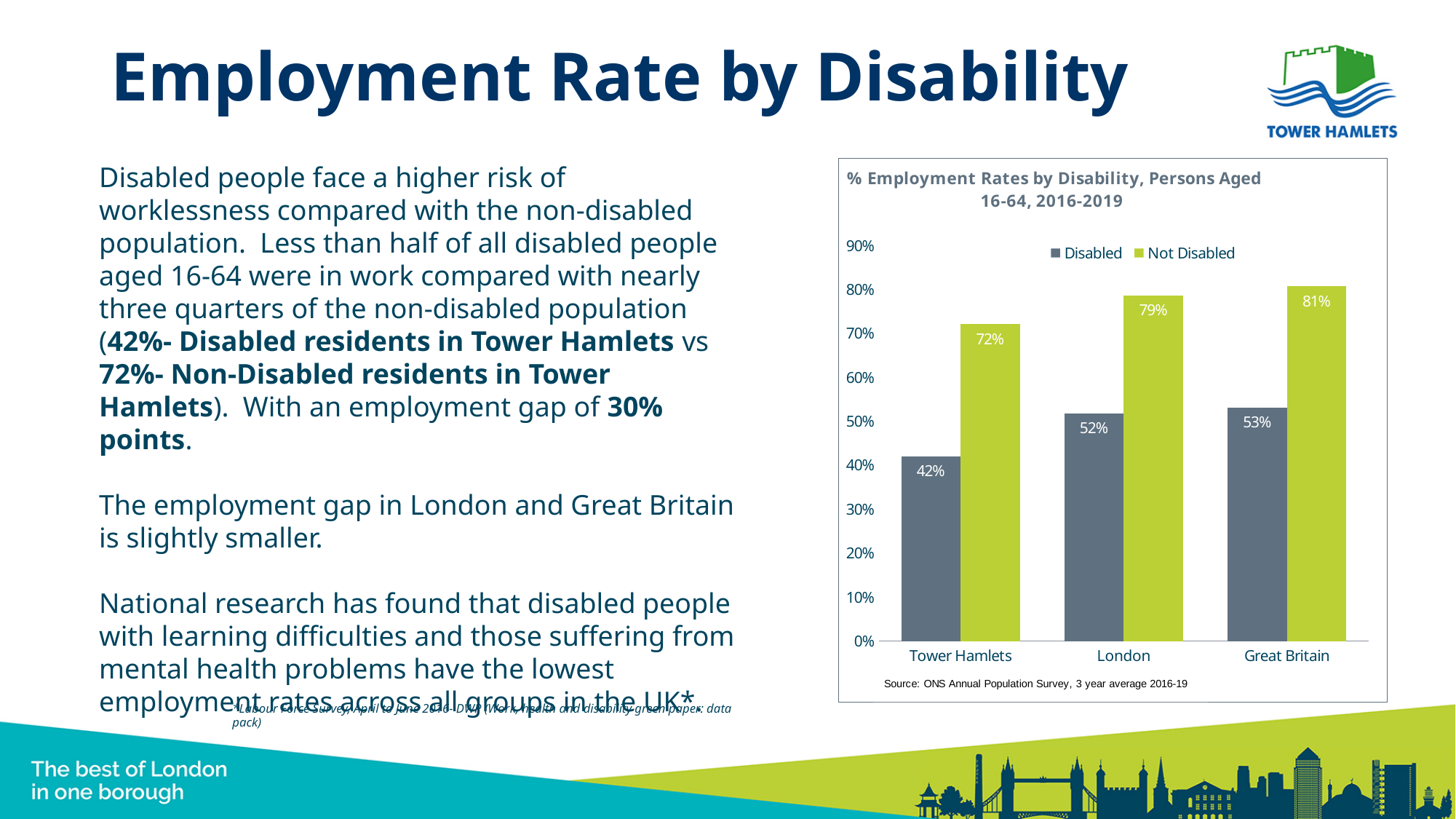
What is the employment rate for disabled people in Tower Hamlets? 42% What is the employment rate for not disabled people in London? 79% How many series does the chart legend list? 2 Which area has the lowest employment rate for disabled people? Tower Hamlets What kind of chart is shown on the slide? Bar chart Is the disabled employment rate in Great Britain greater or less than 50%? greater What is the difference between the not disabled and disabled employment rates in London? 27% Which area has the highest employment rate for not disabled people? Great Britain Which is larger: the disabled employment rate in London or in Tower Hamlets? London What is the employment rate for not disabled people in Great Britain? 81% What is the difference between the not disabled and disabled employment rates in Tower Hamlets? 30% How many areas are shown on the x axis of the chart? 3